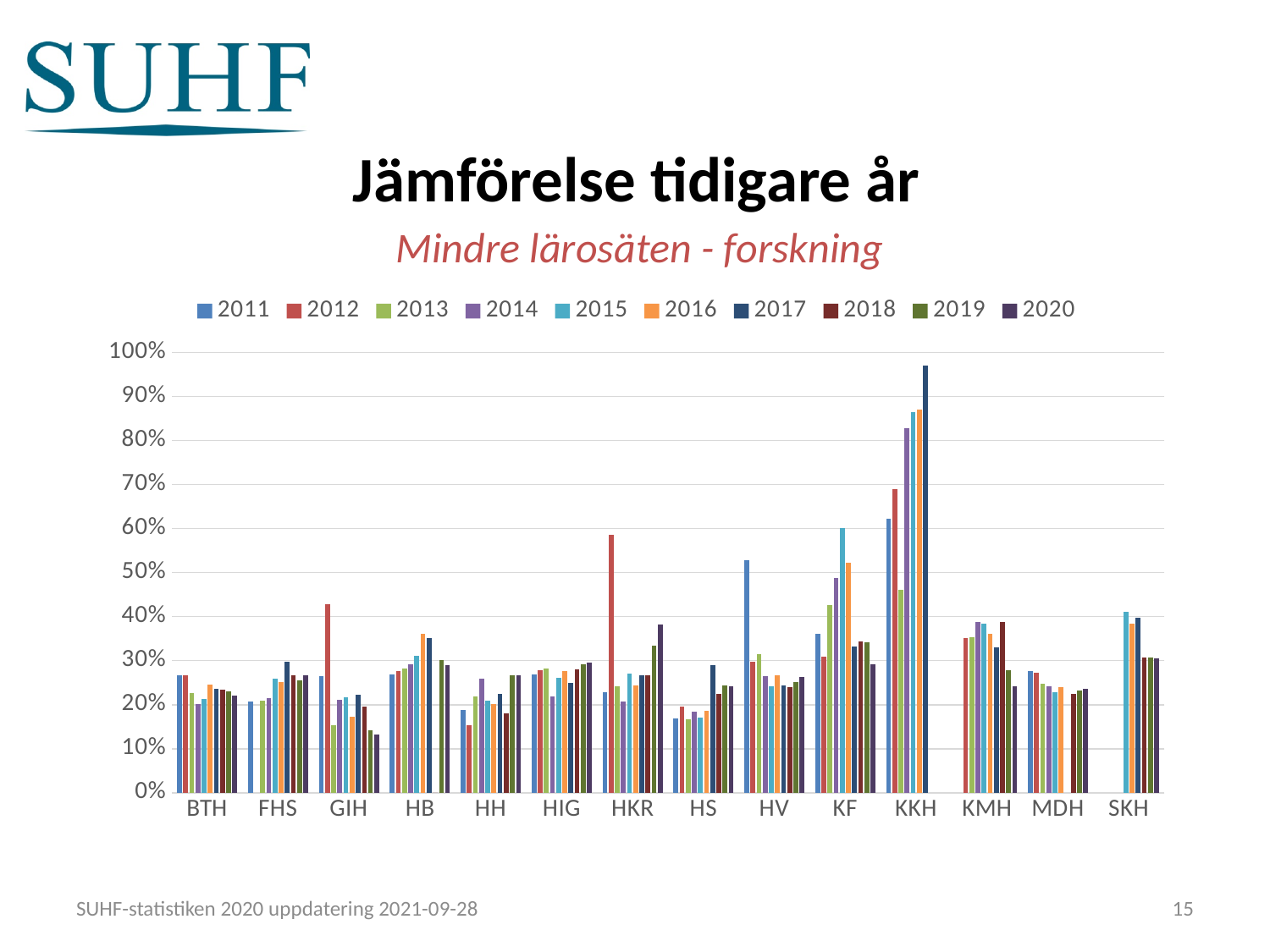
Which category has the lowest value for 2012? HH Which is larger for HKR: the 2011 value or the 2012 value? 2012 Is the value for GIH in 2019 greater or less than 20%? less How many categories are shown on the x axis? 14 Is the value for KKH in 2017 greater or less than 90%? greater Which is larger for KF: the 2015 value or the 2020 value? 2015 How many series does the legend list? 10 Is the value for HKR in 2012 greater or less than 50%? greater What kind of chart is shown on the slide? bar chart Which category has the highest value for 2017? KKH What is the subtitle shown above the chart? Mindre lärosäten - forskning